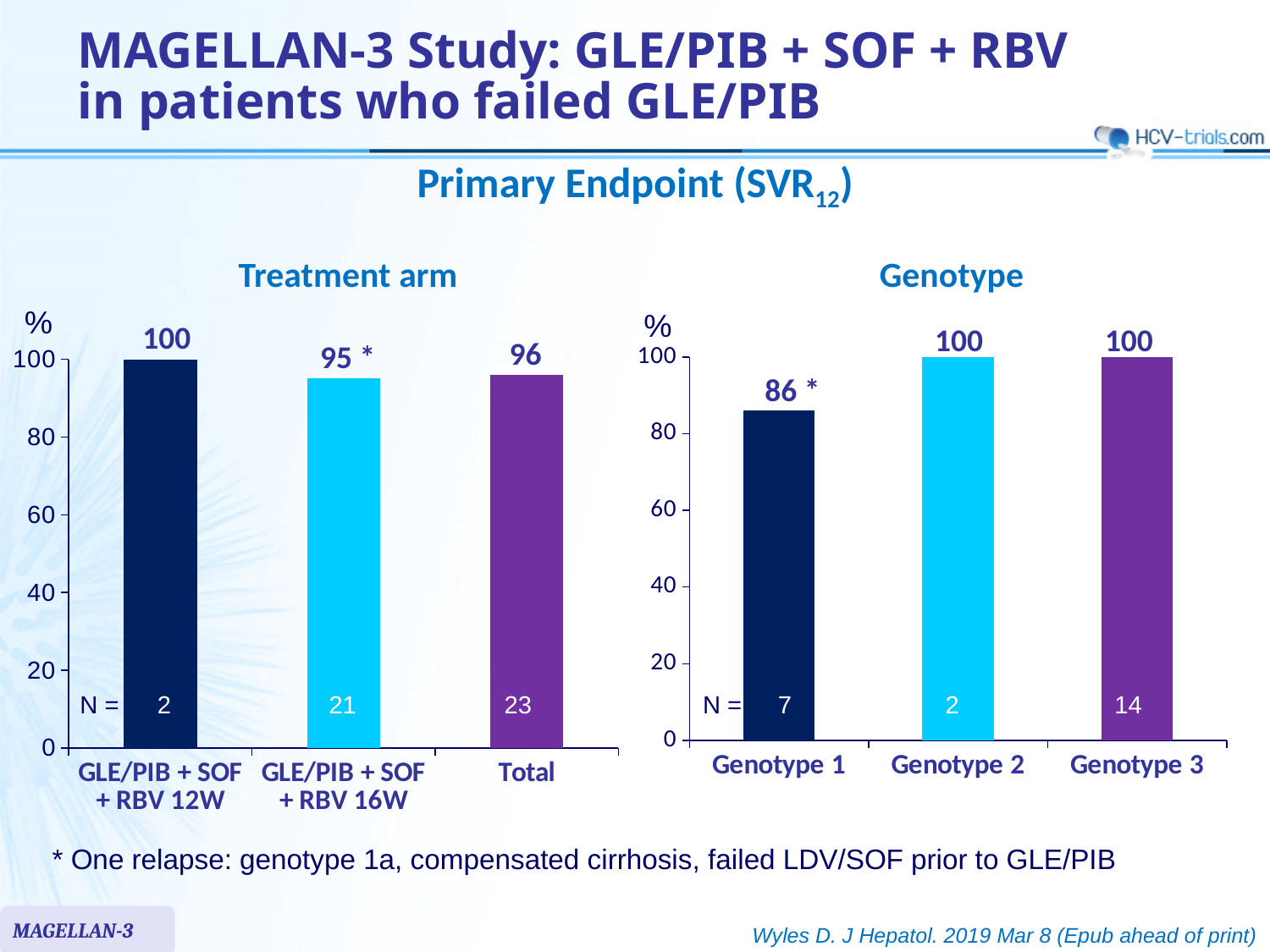
In the Genotype chart, how many patients (N) are in the Genotype 3 group? 14 How many categories are shown in the Genotype chart? 3 In the Treatment arm chart, what is the SVR12 value for GLE/PIB + SOF + RBV 16W? 95 In the Genotype chart, what is the difference between the SVR12 values for Genotype 2 and Genotype 1? 14 What type of chart is the Treatment arm chart? Bar chart In the Treatment arm chart, which treatment arm has the highest SVR12 value? GLE/PIB + SOF + RBV 12W In the Treatment arm chart, what is the SVR12 value for GLE/PIB + SOF + RBV 12W? 100 In the Genotype chart, what is the SVR12 value for Genotype 1? 86 In the Treatment arm chart, what is the difference between the SVR12 values for the 12W arm and the 16W arm? 5 In the Genotype chart, which genotype has the lowest SVR12 value? Genotype 1 In the Treatment arm chart, how many patients (N) are in the GLE/PIB + SOF + RBV 16W arm? 21 In the Treatment arm chart, what is the SVR12 value for Total? 96